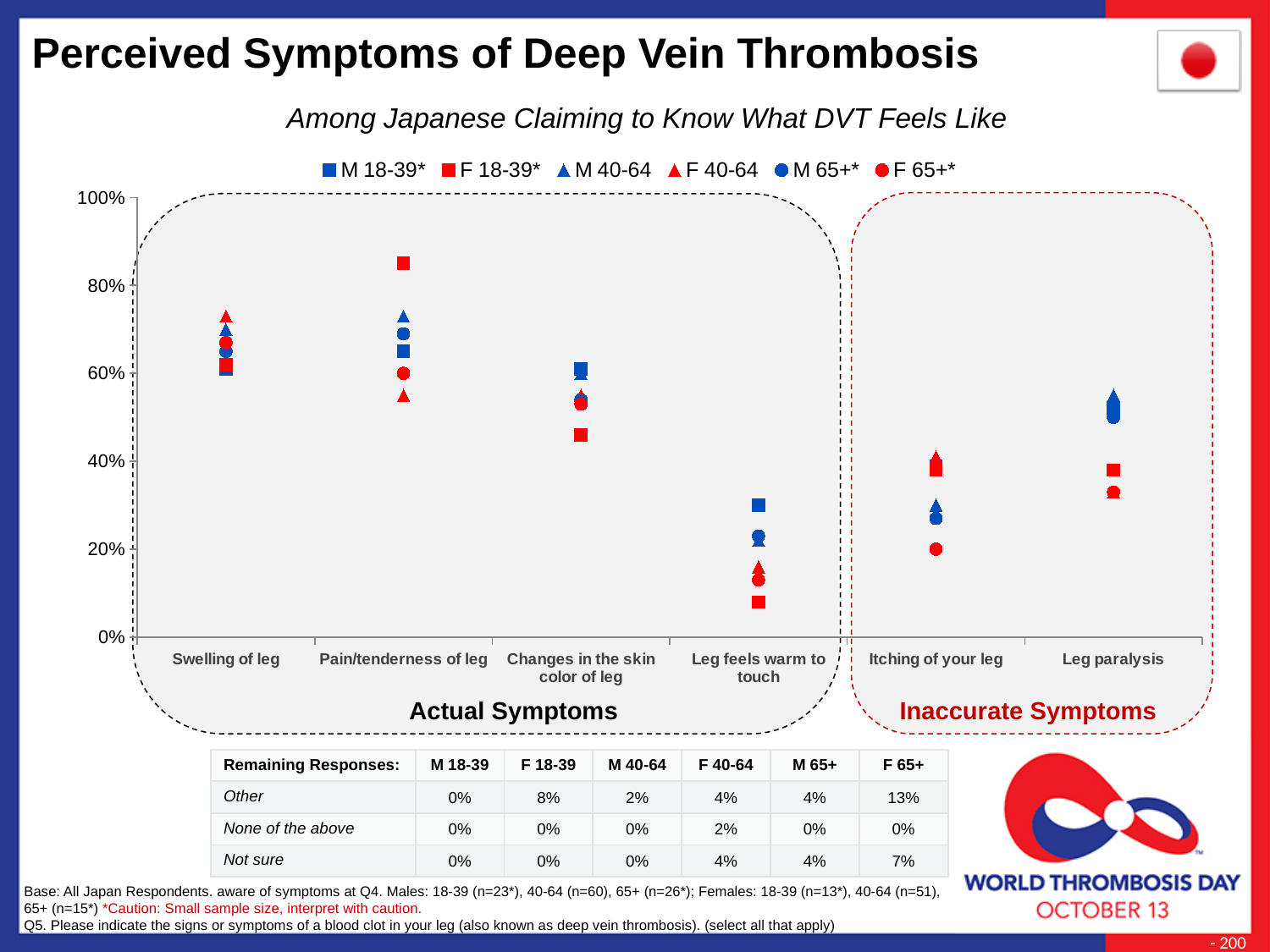
Which two symptoms are grouped under the label 'Inaccurate Symptoms'? Itching of your leg and Leg paralysis Is the value for M 18-39 on Leg feels warm to touch greater or less than 20%? greater Is the value for F 18-39 on Changes in the skin color of leg greater or less than 60%? less How many series does the legend list? 6 Is the value for M 40-64 on Leg paralysis greater or less than 40%? greater For Pain/tenderness of leg, which is larger: F 18-39 or F 40-64? F 18-39 How many symptom categories are shown on the x axis? 6 What kind of chart is this? Scatter (dot) chart What is the title of the chart? Perceived Symptoms of Deep Vein Thrombosis Which symptom category contains the single highest plotted point? Pain/tenderness of leg